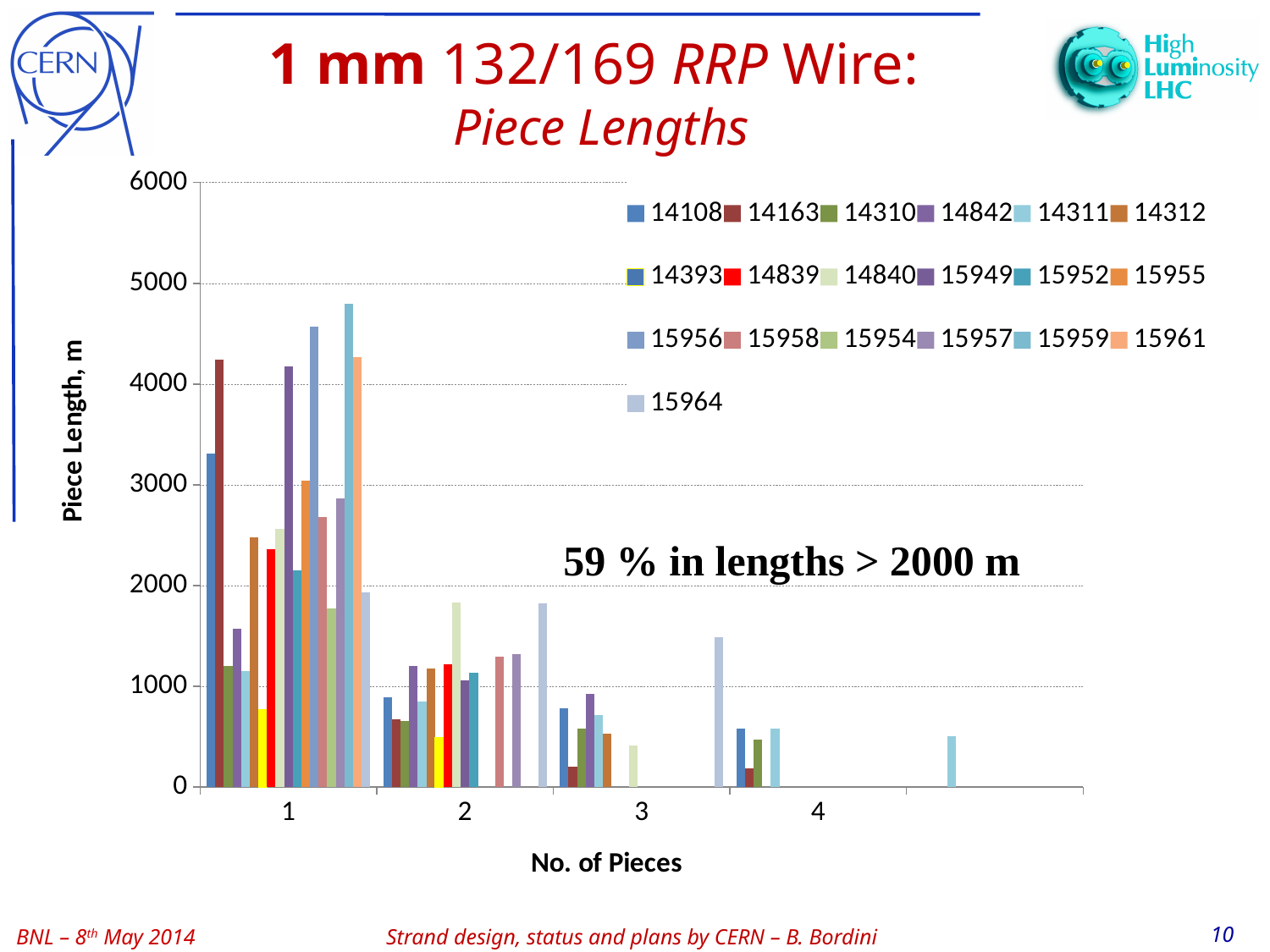
What is the title of the vertical axis of the chart? Piece Length, m Is the value for series 14839 at 1 piece greater or less than 2000? greater What is the title of the horizontal axis of the chart? No. of Pieces Is the value for series 15964 at 2 pieces greater or less than 2000? less Which is larger: the value for series 14163 at 1 piece or the value for series 14163 at 2 pieces? 1 piece What kind of chart is shown on the slide? bar chart Is the value for series 15964 at 3 pieces greater or less than 1000? greater How many series does the chart legend list? 19 Do the piece lengths generally rise or fall as the number of pieces increases along the x axis? fall